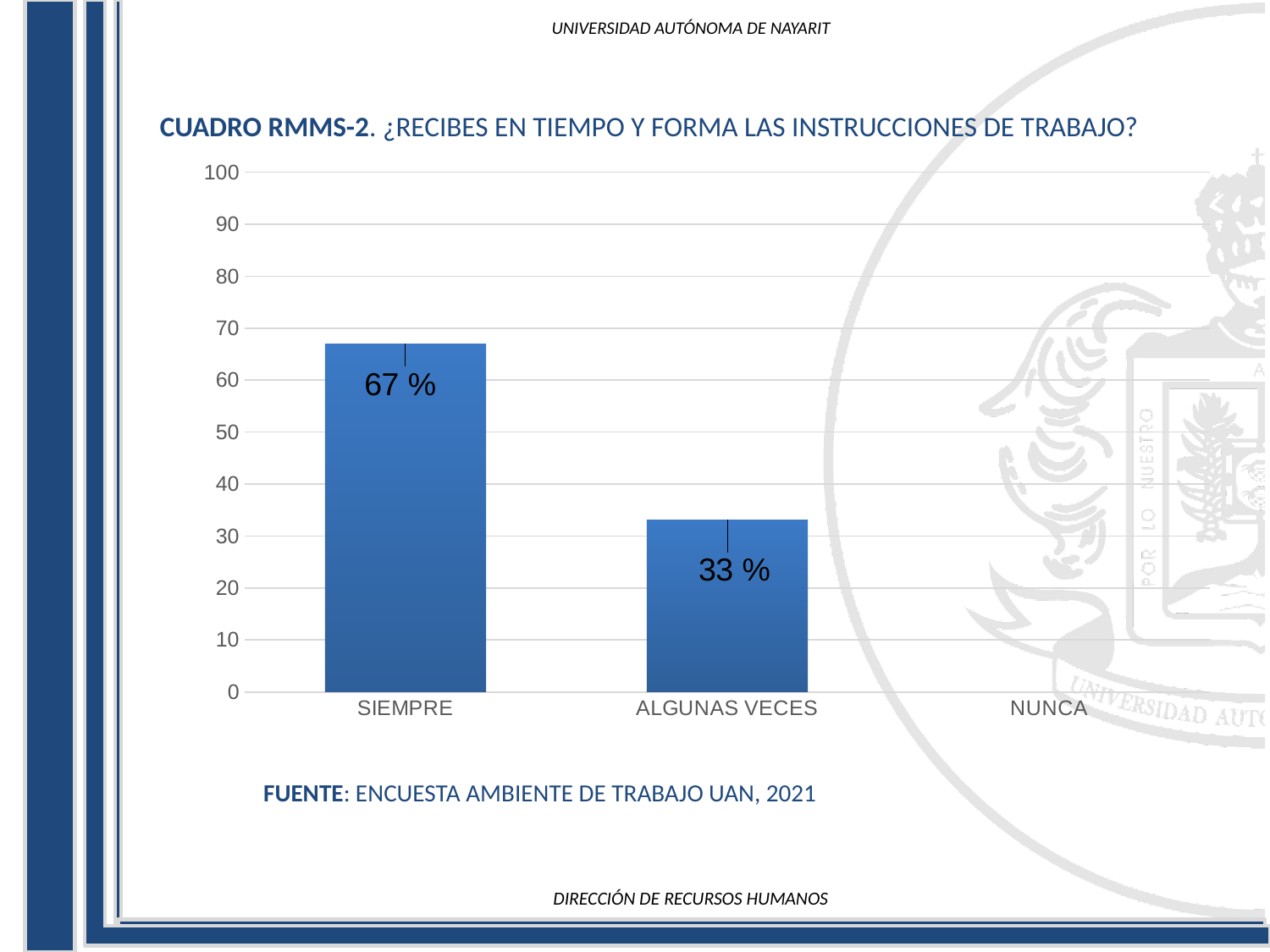
Do the values rise or fall from left to right along the x axis? fall What kind of chart is shown on the slide? bar chart What is the value for ALGUNAS VECES? 33 % What is the difference between the values for SIEMPRE and ALGUNAS VECES? 34 % How many categories are shown on the x axis? 3 Is the value for ALGUNAS VECES greater or less than 40? less What is the source cited below the chart? ENCUESTA AMBIENTE DE TRABAJO UAN, 2021 Is the value for SIEMPRE greater or less than 60? greater What is the value for SIEMPRE? 67 % Which is larger, the value for SIEMPRE or the value for ALGUNAS VECES? SIEMPRE Which category has the highest value? SIEMPRE